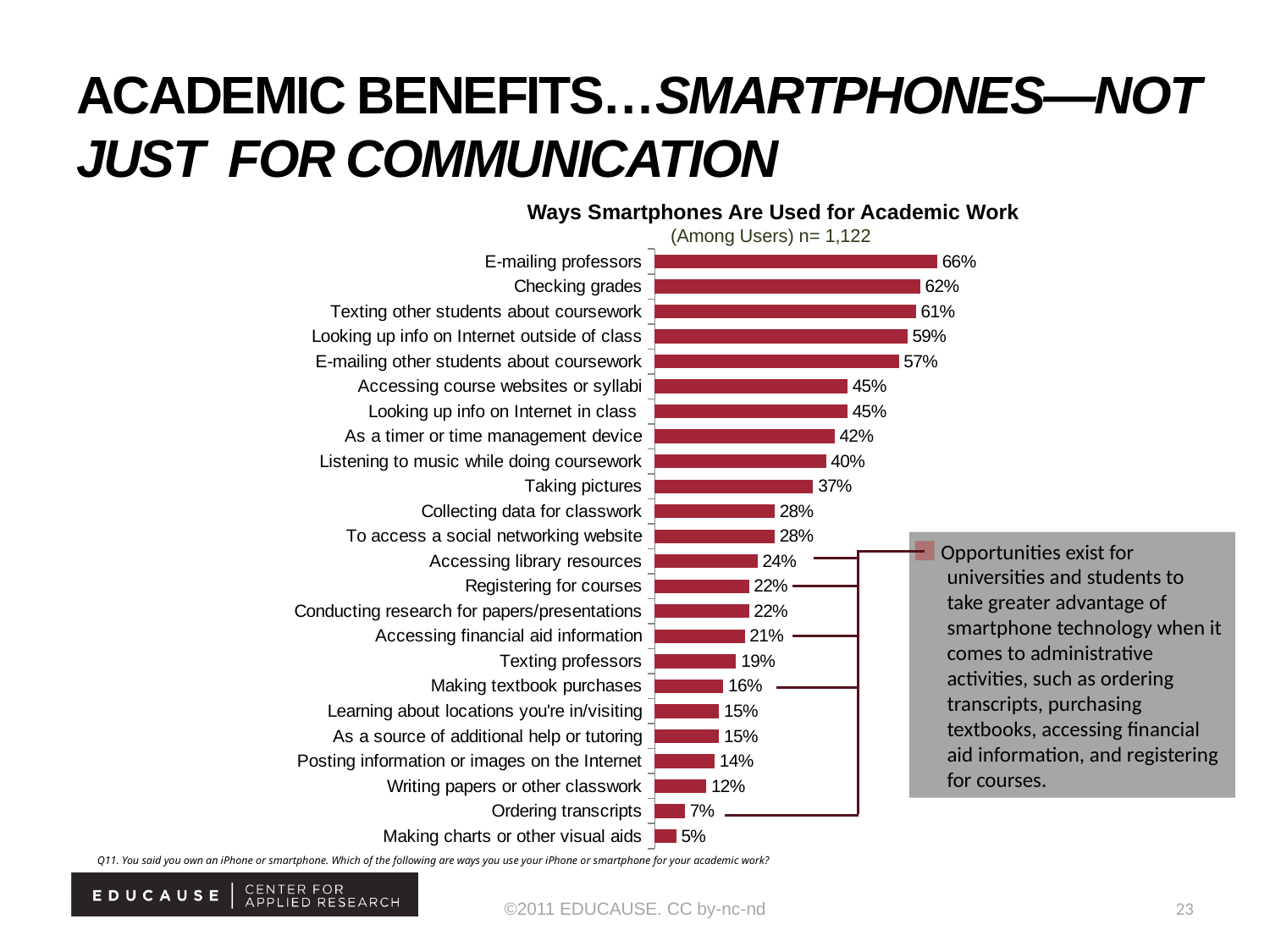
Which category has the lowest value in the chart? Making charts or other visual aids What is the title of the chart? Ways Smartphones Are Used for Academic Work What kind of chart is shown on the slide? Bar chart What percentage of users reported e-mailing professors as a way they use their smartphone for academic work? 66% What percentage is shown for 'Accessing financial aid information'? 21% What is the value shown for 'Ordering transcripts'? 7% What is the difference between the values for 'Checking grades' and 'Making textbook purchases'? 46% How many categories are plotted in the chart? 24 Which category has the highest value in the chart? E-mailing professors Which is larger: the value for 'Taking pictures' or the value for 'Texting professors'? Taking pictures What is the difference between the values for 'Accessing library resources' and 'Ordering transcripts'? 17% What is the sample size (n) stated in the chart subtitle? 1,122